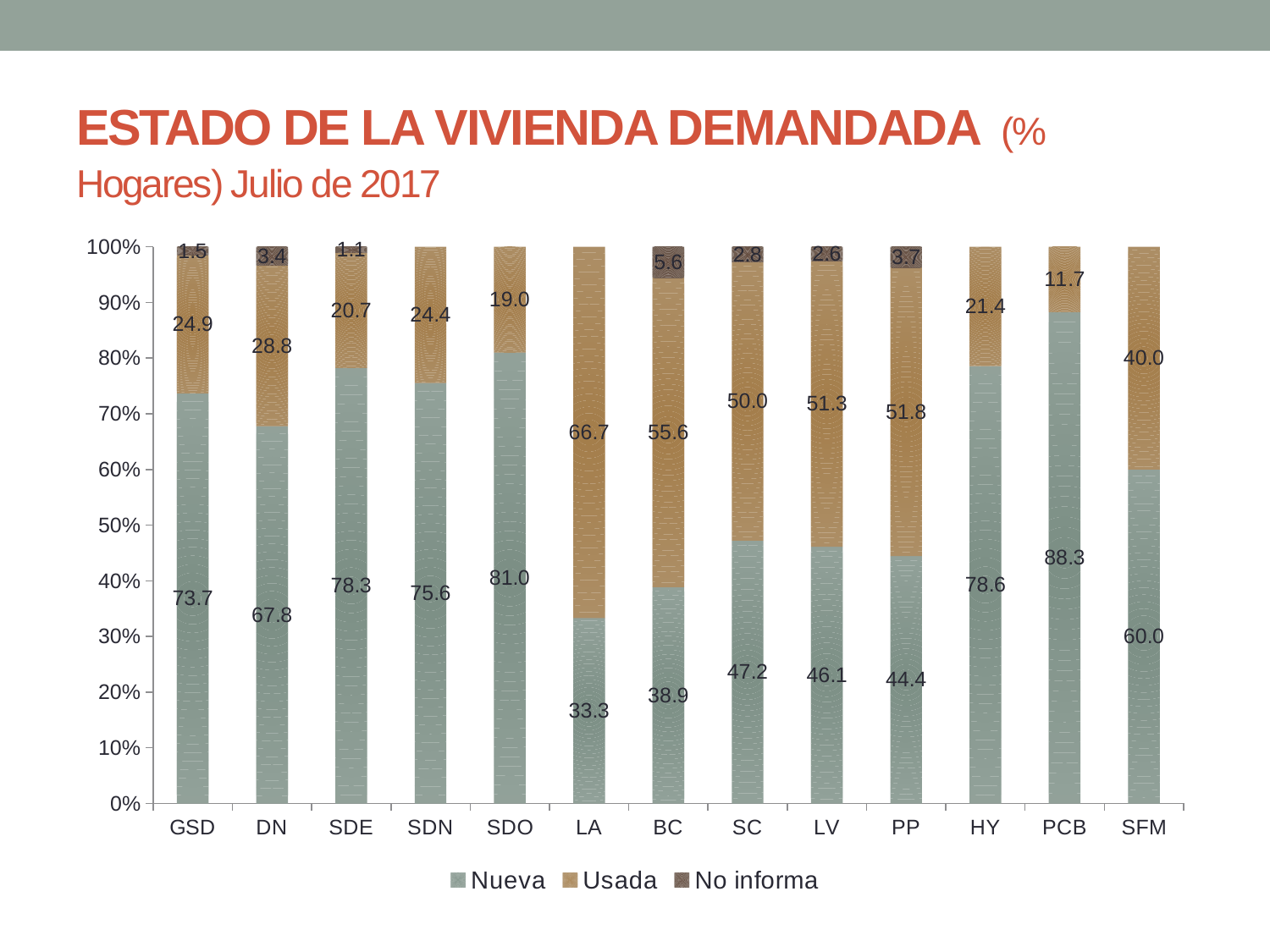
What kind of chart is shown on the slide? Stacked bar chart How many series does the legend list? 3 Which is larger, the Nueva value for SDO or the Nueva value for HY? SDO Which category has the lowest Nueva value? LA What is the Usada value for LA? 66.7 What is the Nueva value for PCB? 88.3 What is the difference between the Nueva and Usada values for SFM? 20.0 What is the No informa value for BC? 5.6 What are the three series listed in the legend? Nueva, Usada, No informa Which category has the highest No informa value? BC Which category has the highest Nueva value? PCB How many categories are shown on the x axis? 13